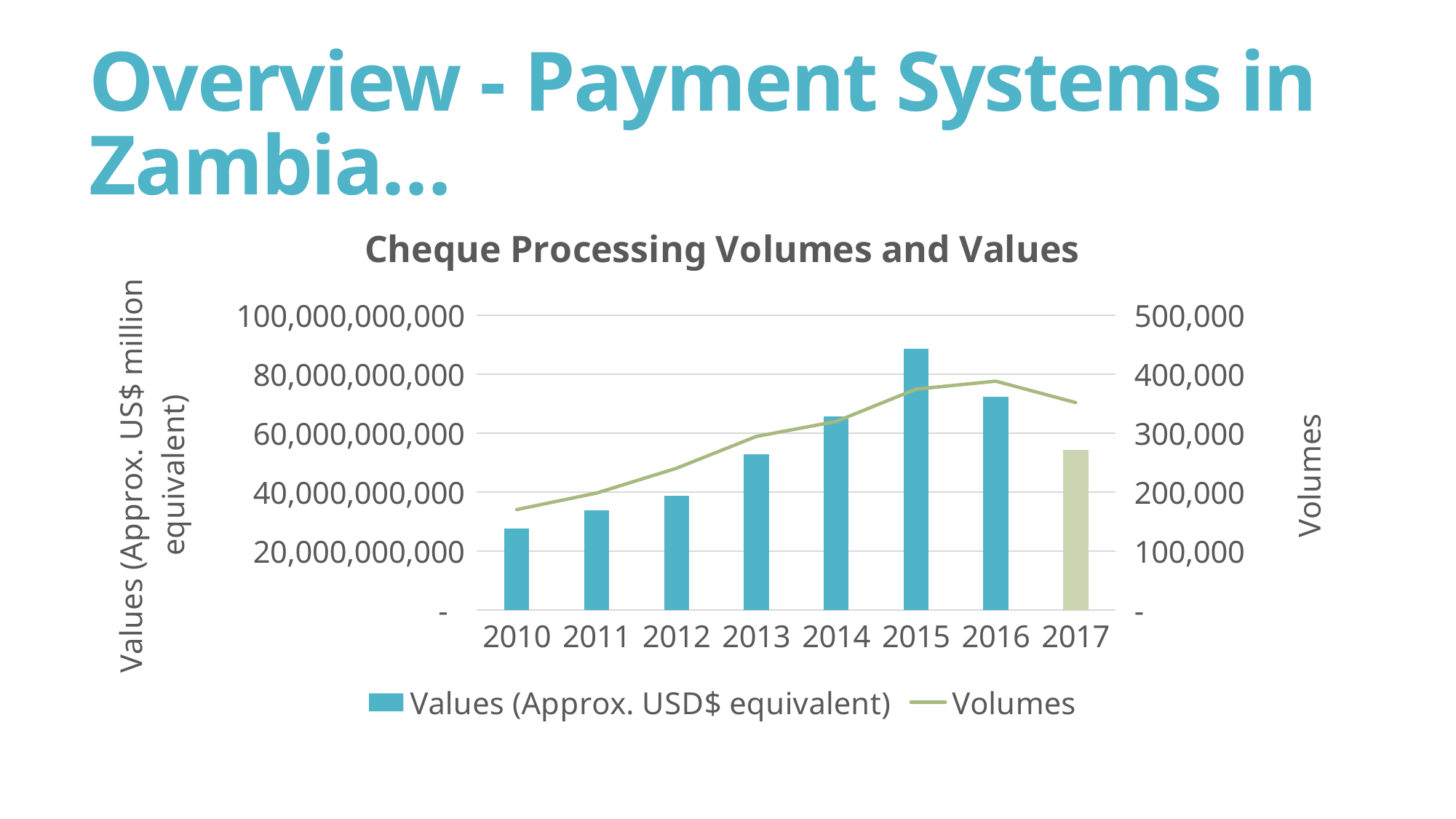
Is the Values bar for 2010 greater or less than 40,000,000,000? less In which year is the Values bar the highest? 2015 Do the Values bars rise or fall from 2010 to 2015? rise Is the Values bar for 2015 greater or less than 80,000,000,000? greater What kind of chart is used to show the Values series? Bar chart In which year is the Values bar the lowest? 2010 Is the Volumes value for 2010 greater or less than 200,000? less What is the title of the chart? Cheque Processing Volumes and Values How many series does the legend list? 2 Which year has the larger Values bar, 2016 or 2017? 2016 How many years are shown on the x axis? 8